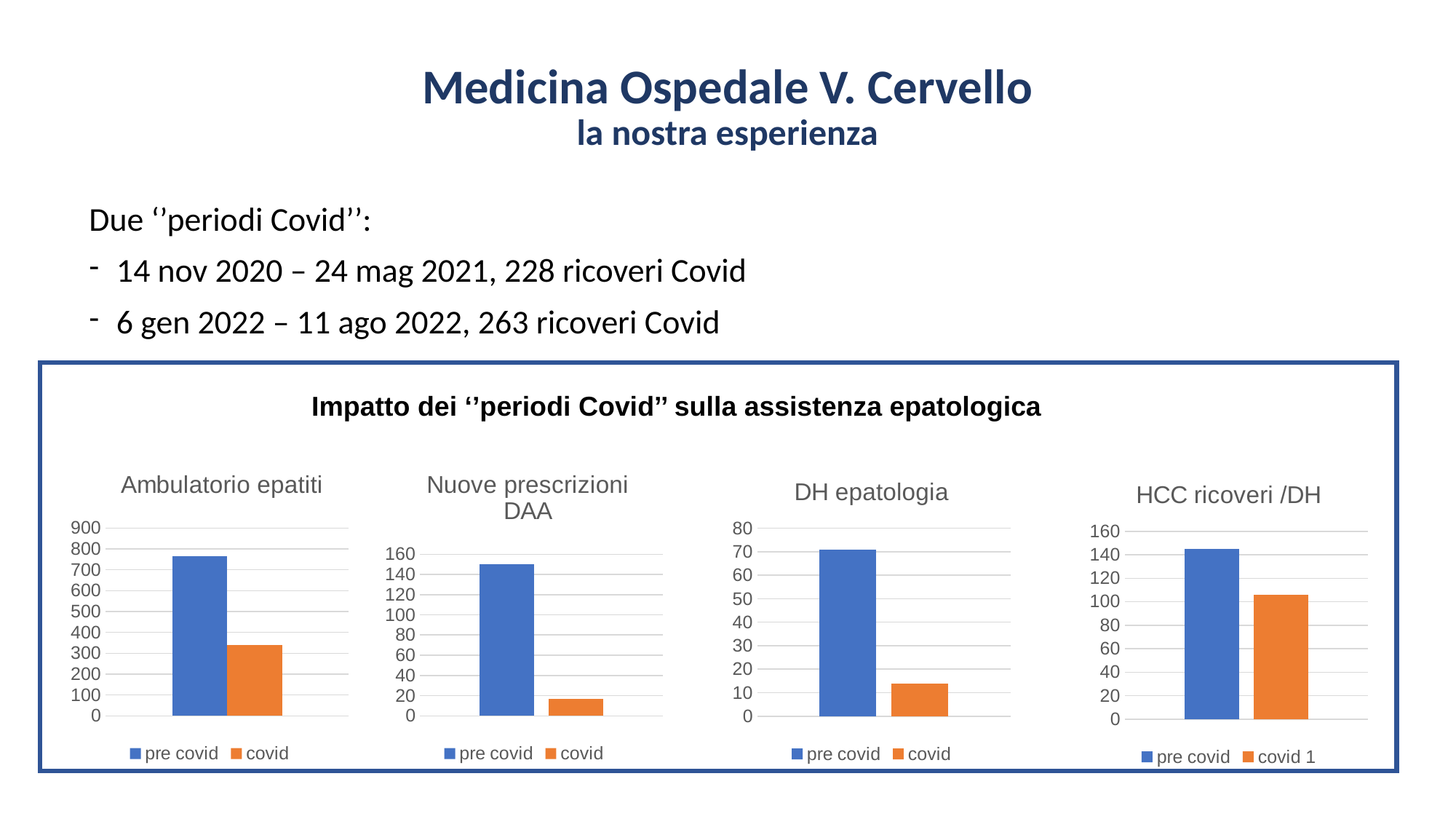
In the 'Nuove prescrizioni DAA' chart, is the value for pre covid greater or less than 140? greater In the 'HCC ricoveri /DH' chart, is the value for covid 1 greater or less than 80? greater In the 'Ambulatorio epatiti' chart, which series has the higher value, pre covid or covid? pre covid In the 'HCC ricoveri /DH' chart, which series has the larger value, pre covid or covid 1? pre covid What type of chart is the 'DH epatologia' chart? bar chart What is the overall title above the four charts? Impatto dei ''periodi Covid'' sulla assistenza epatologica In the 'Ambulatorio epatiti' chart, is the value for covid greater or less than 400? less How many series does the legend of the 'HCC ricoveri /DH' chart list? 2 In the 'DH epatologia' chart, which series is lower, pre covid or covid? covid